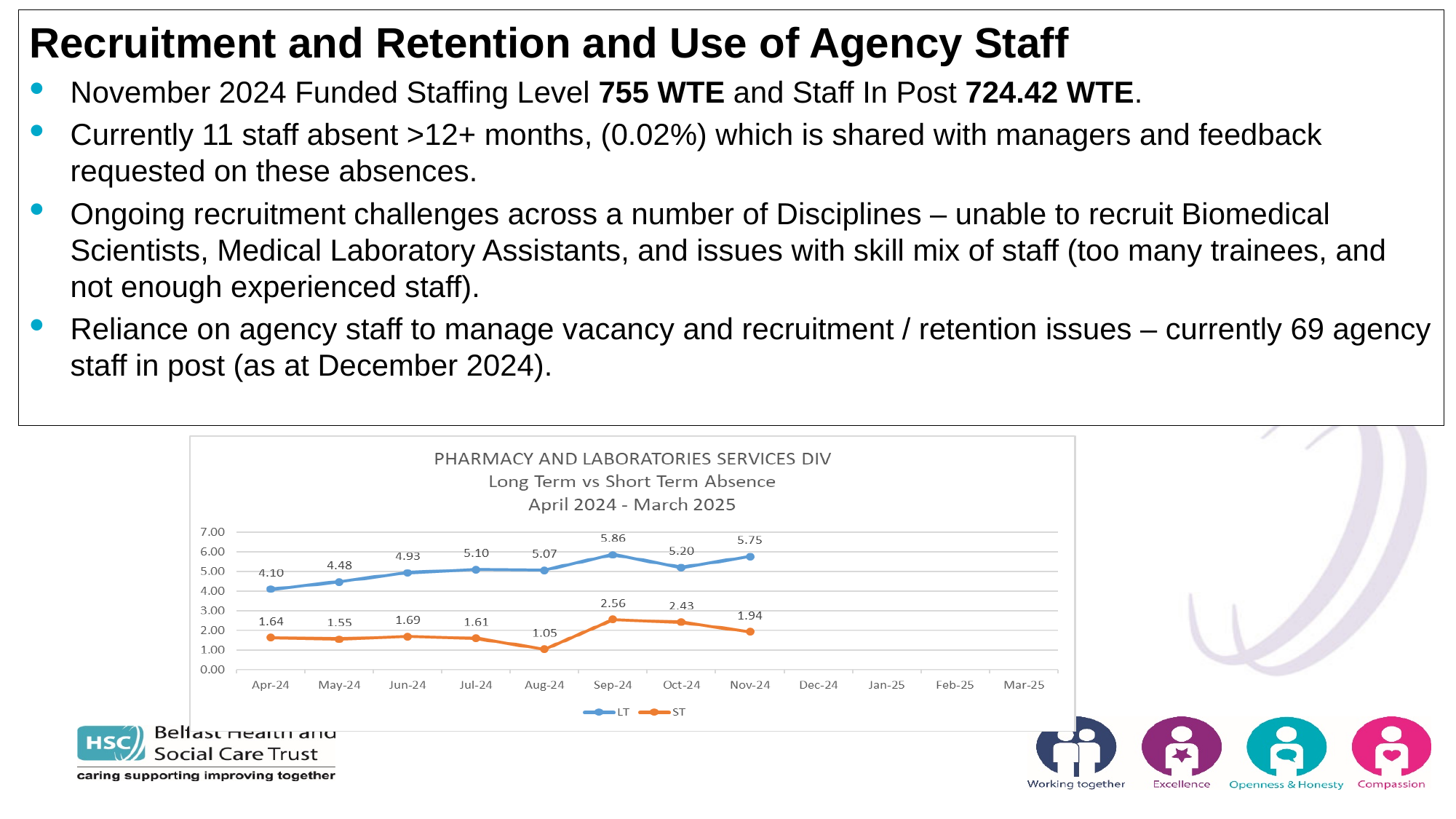
What is the title of the chart? PHARMACY AND LABORATORIES SERVICES DIV Long Term vs Short Term Absence April 2024 - March 2025 What kind of chart is shown on the slide? Line chart What is the LT value for Sep-24? 5.86 How many series does the legend list? 2 Does the LT series generally rise or fall from Apr-24 to Sep-24? Rise What is the LT value for Apr-24? 4.10 What is the difference between the LT and ST values in Nov-24? 3.81 Which month has the highest ST value? Sep-24 Which month has the lowest LT value? Apr-24 What is the ST value for Aug-24? 1.05 Which is larger, the ST value for Oct-24 or the ST value for Jun-24? Oct-24 How many months have plotted data points for the LT series? 8